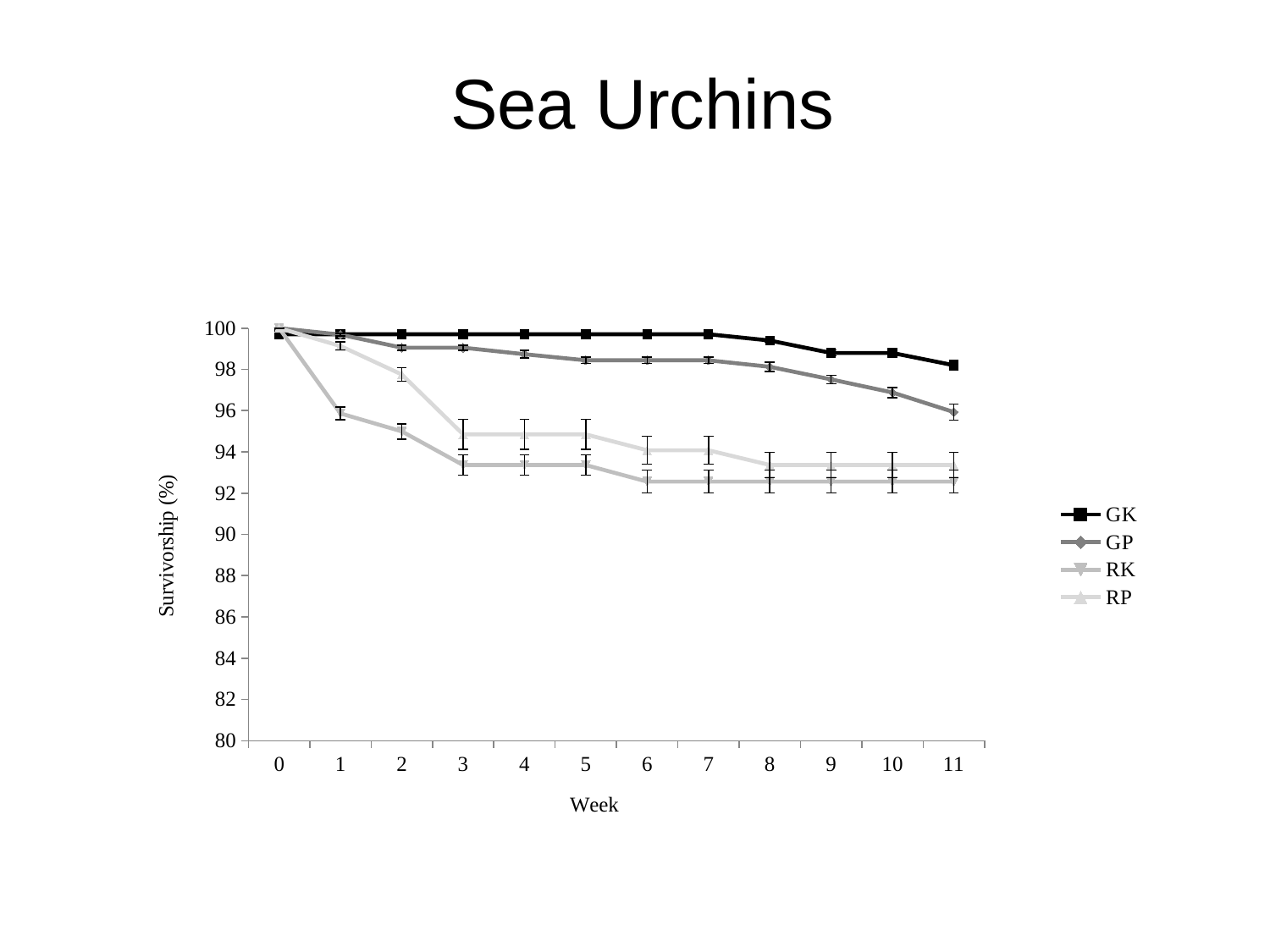
Is the value for GP at week 11 greater or less than 98? less Does the survivorship for GP rise or fall from week 0 to week 11? fall Is the value for GK at week 5 greater or less than 98? greater Which series has the highest survivorship at week 11? GK How many weeks are plotted along the x axis? 12 At week 2, which series has the higher survivorship, RK or RP? RP Is the value for RK at week 11 greater or less than 94? less What is the label of the x axis? Week How many series does the legend list? 4 What kind of chart is shown on the slide? line chart Which series has the lowest survivorship at week 11? RK What is the label of the y axis? Survivorship (%)